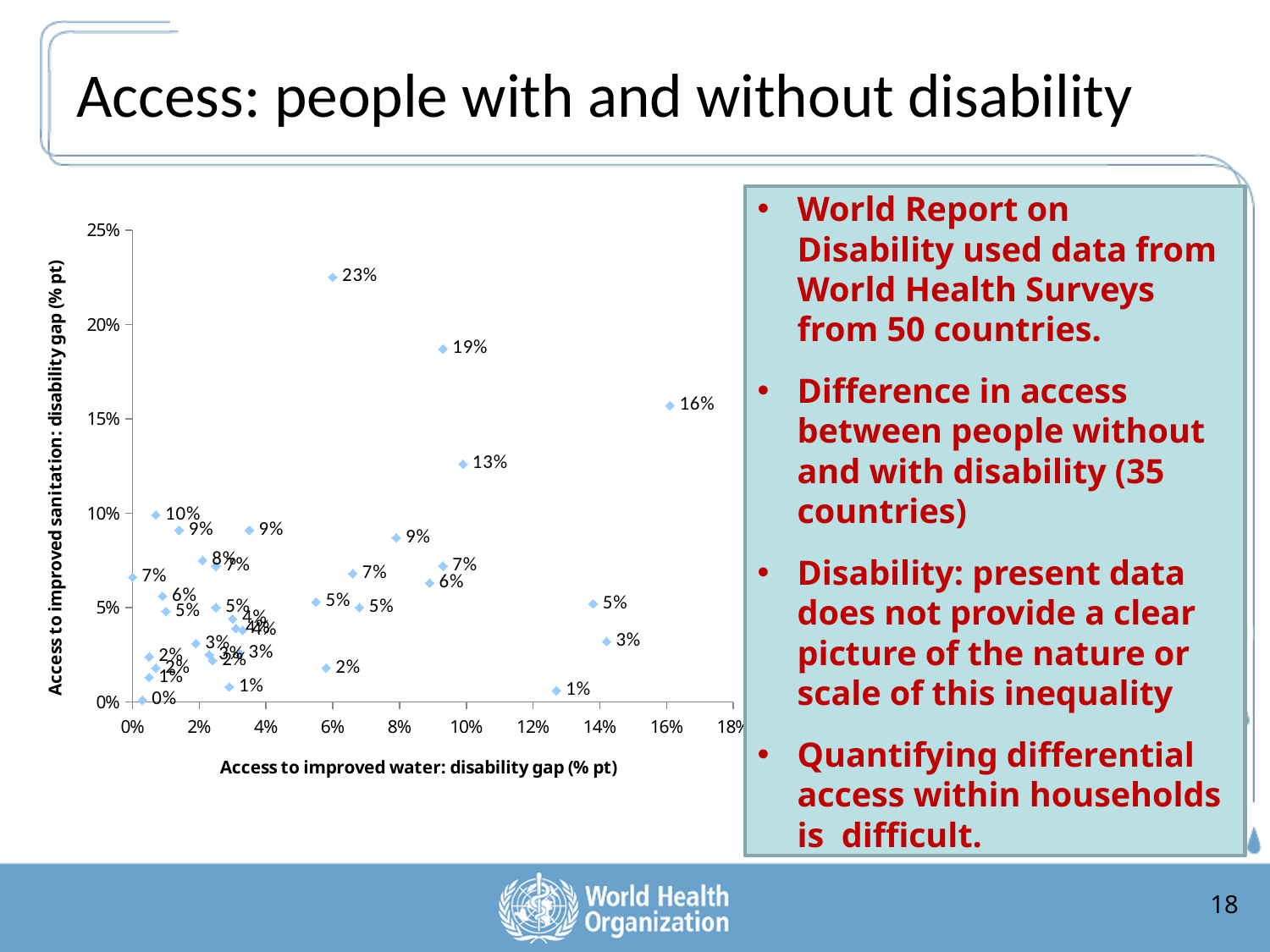
Which is larger: the sanitation gap of the point labelled 13% or the point labelled 16%? 16% What is the sanitation gap label of the point with the largest water disability gap (the rightmost point)? 16% What kind of chart is shown on the slide? scatter chart Is the water disability gap of the point labelled 19% greater or less than 8%? greater What is the lowest sanitation disability gap value labelled on the chart? 0% What is the highest sanitation disability gap value labelled on the chart? 23% Is the water disability gap of the point labelled 16% greater or less than 14%? greater What is the difference between the two highest labelled sanitation gap values (23% and 19%)? 4 percentage points What is the title of the vertical axis? Access to improved sanitation: disability gap (% pt) Is the water disability gap of the point labelled 23% greater or less than 8%? less What is the title of the horizontal axis? Access to improved water: disability gap (% pt) How many points on the chart have a labelled sanitation gap above 10%? 4